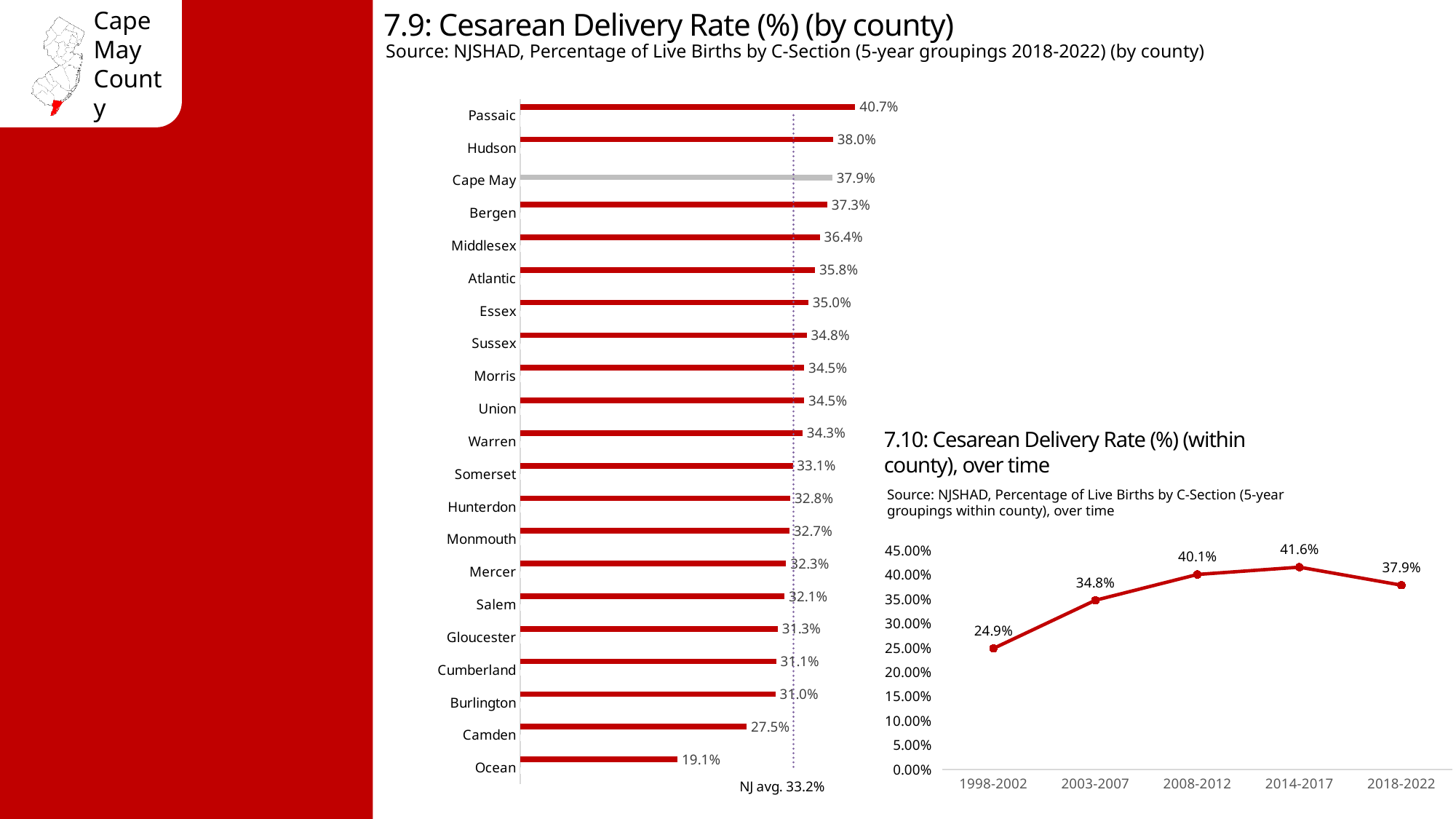
In the 7.9 Cesarean Delivery Rate (by county) chart, which is larger, Hudson or Bergen? Hudson In the 7.10 Cesarean Delivery Rate (within county) over time chart, what is the value for 2014-2017? 41.6% In the 7.9 Cesarean Delivery Rate (by county) chart, how many counties are shown? 21 In the 7.10 Cesarean Delivery Rate (within county) over time chart, which period has the lowest value? 1998-2002 In the 7.10 Cesarean Delivery Rate (within county) over time chart, what is the difference between 2014-2017 and 2018-2022? 3.7% What kind of chart is the 7.10 Cesarean Delivery Rate (within county) over time chart? Line chart In the 7.9 Cesarean Delivery Rate (by county) chart, what is the NJ average shown by the dotted line? 33.2% In the 7.9 Cesarean Delivery Rate (by county) chart, which county has the highest rate? Passaic In the 7.9 Cesarean Delivery Rate (by county) chart, what is the value for Cape May? 37.9% What kind of chart is the 7.9 Cesarean Delivery Rate (by county) chart? Bar chart In the 7.9 Cesarean Delivery Rate (by county) chart, what is the difference between Passaic and Ocean? 21.6% In the 7.9 Cesarean Delivery Rate (by county) chart, which county has the lowest rate? Ocean